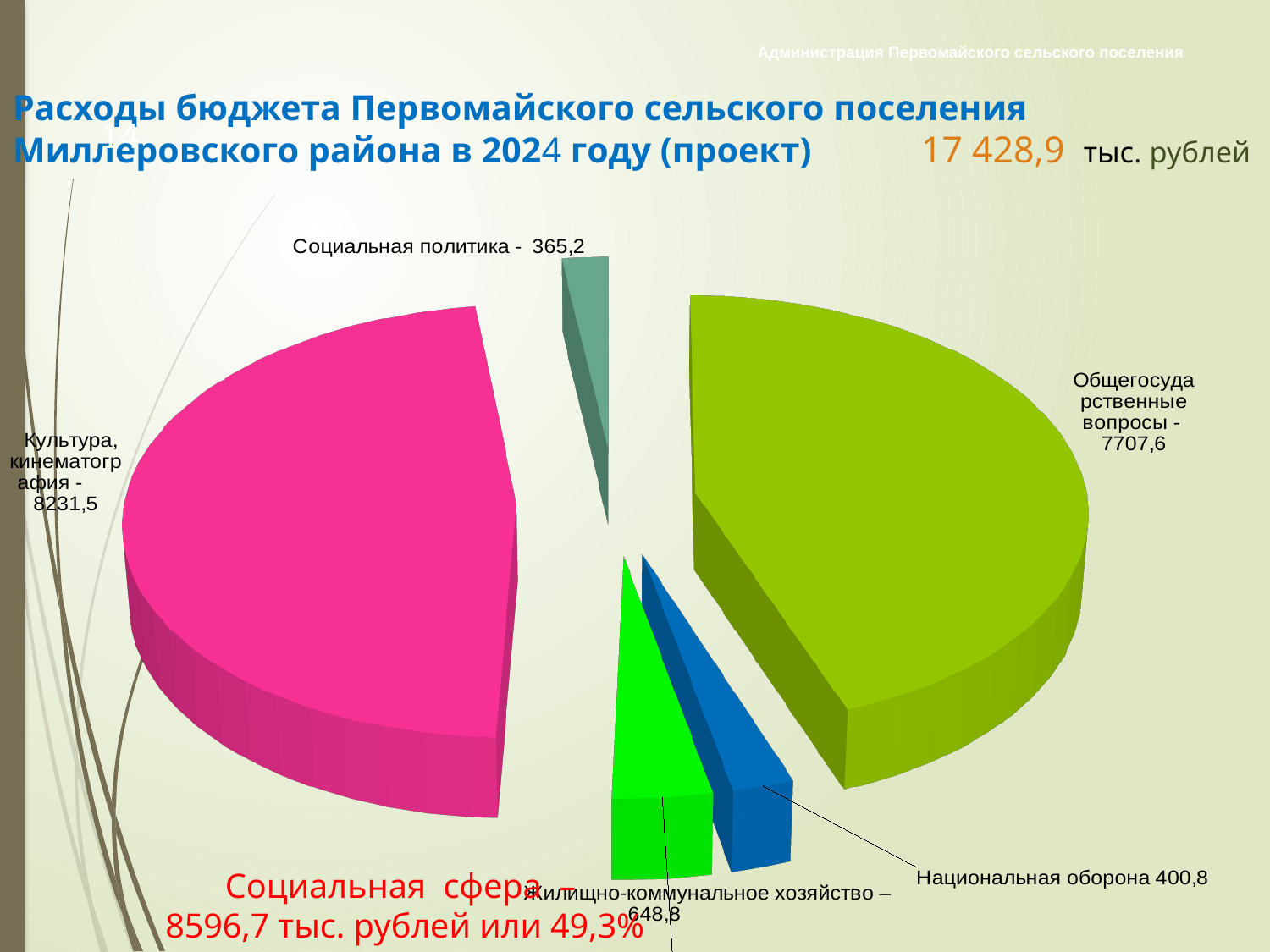
How many slices does the pie chart have? 5 What total budget expenditure amount is shown next to the slide title? 17 428,9 тыс. рублей What is the difference between Культура, кинематография and Общегосударственные вопросы? 523,9 Which category has the smallest value in the pie chart? Социальная политика What is the value for Культура, кинематография? 8231,5 What is the value for Национальная оборона? 400,8 Which is larger: Жилищно-коммунальное хозяйство or Национальная оборона? Жилищно-коммунальное хозяйство What is the value for Общегосударственные вопросы? 7707,6 What is the value for Жилищно-коммунальное хозяйство? 648,8 What is the value for Социальная политика? 365,2 What type of chart is shown on the slide? pie chart Which category has the largest value in the pie chart? Культура, кинематография